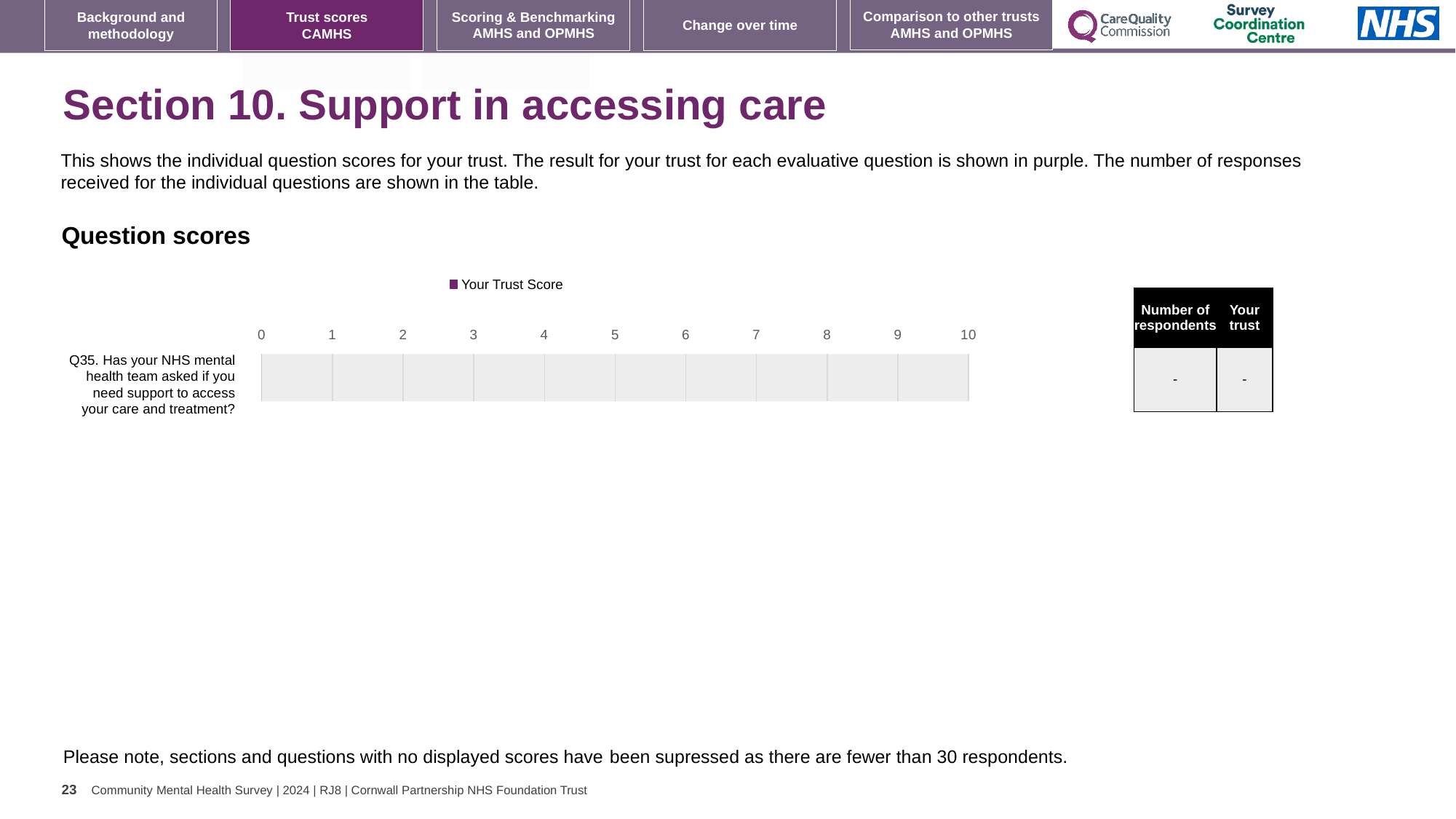
Which question is listed on the Question scores chart? Q35. Has your NHS mental health team asked if you need support to access your care and treatment? Is a bar plotted for Q35 on the Question scores chart? No How many questions (categories) are listed on the Question scores chart? 1 What value is shown in the 'Your trust' column of the table for Q35? - What value is shown in the 'Number of respondents' column of the table for Q35? - What is the lowest value shown on the x axis of the Question scores chart? 0 How many series does the legend of the Question scores chart list? 1 What is the name of the series shown in the legend of the Question scores chart? Your Trust Score Why are no scores displayed for Q35 on this slide? Fewer than 30 respondents What is the highest value shown on the x axis of the Question scores chart? 10